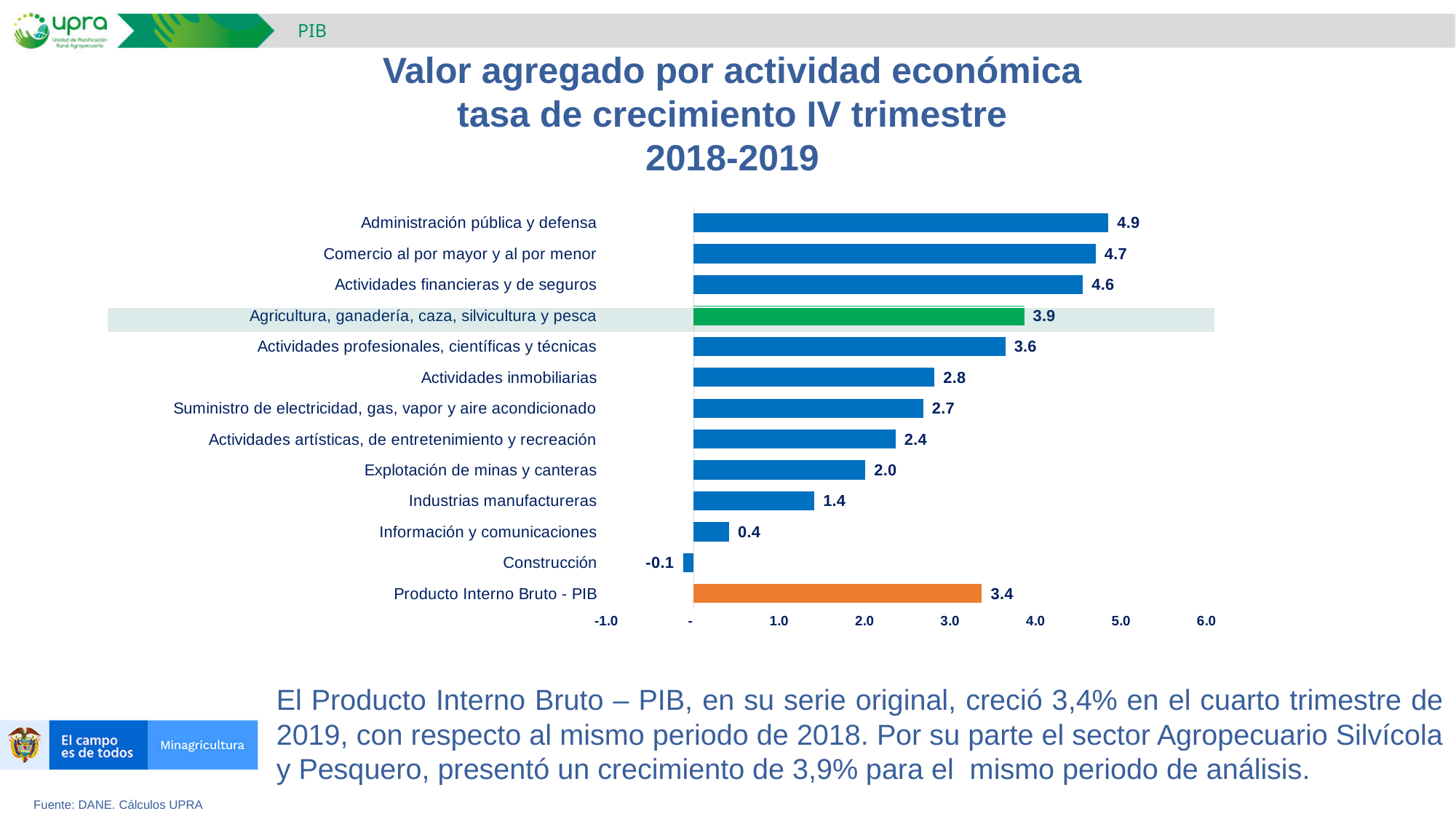
Which is larger, Actividades inmobiliarias or Explotación de minas y canteras? Actividades inmobiliarias What is the value for Información y comunicaciones? 0.4 Which category has the highest value? Administración pública y defensa Is the value for Industrias manufactureras greater or less than 2.0? less What is the difference between Administración pública y defensa and Comercio al por mayor y al por menor? 0.2 How many categories are shown in the chart? 13 What kind of chart is shown on the slide? bar chart Which category has the lowest value? Construcción What is the value for Construcción? -0.1 What colour is the bar for Producto Interno Bruto - PIB? orange What is the value for Agricultura, ganadería, caza, silvicultura y pesca? 3.9 What is the value for Producto Interno Bruto - PIB? 3.4